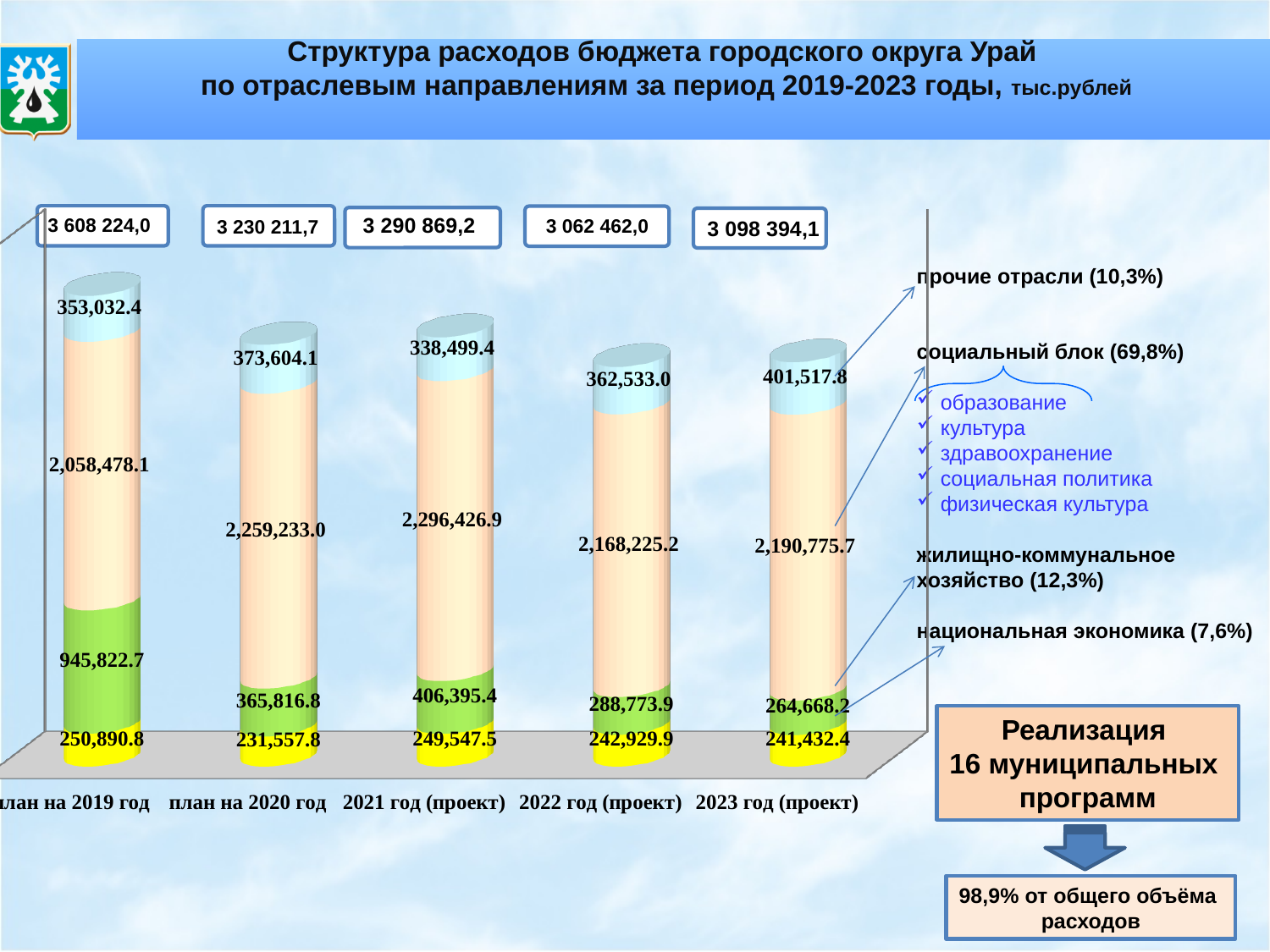
What is the total budget expenditure shown for план на 2019 год? 3 608 224,0 What is the value of the жилищно-коммунальное хозяйство segment for план на 2019 год? 945,822.7 In which year is the социальный блок segment the highest? 2021 год (проект) How many years (categories) are shown on the chart? 5 How many expenditure segments (series) make up each bar? 4 In which year is the национальная экономика segment the lowest? план на 2020 год Which is larger: the прочие отрасли value for 2023 год (проект) or for план на 2020 год? 2023 год (проект) What is the value of the социальный блок segment for план на 2020 год? 2,259,233.0 What is the value of the национальная экономика segment for 2023 год (проект)? 241,432.4 What is the value of the прочие отрасли segment for 2022 год (проект)? 362,533.0 What is the difference between the социальный блок values for 2021 год (проект) and план на 2020 год? 37,193.9 What kind of chart is shown on the slide? stacked bar chart